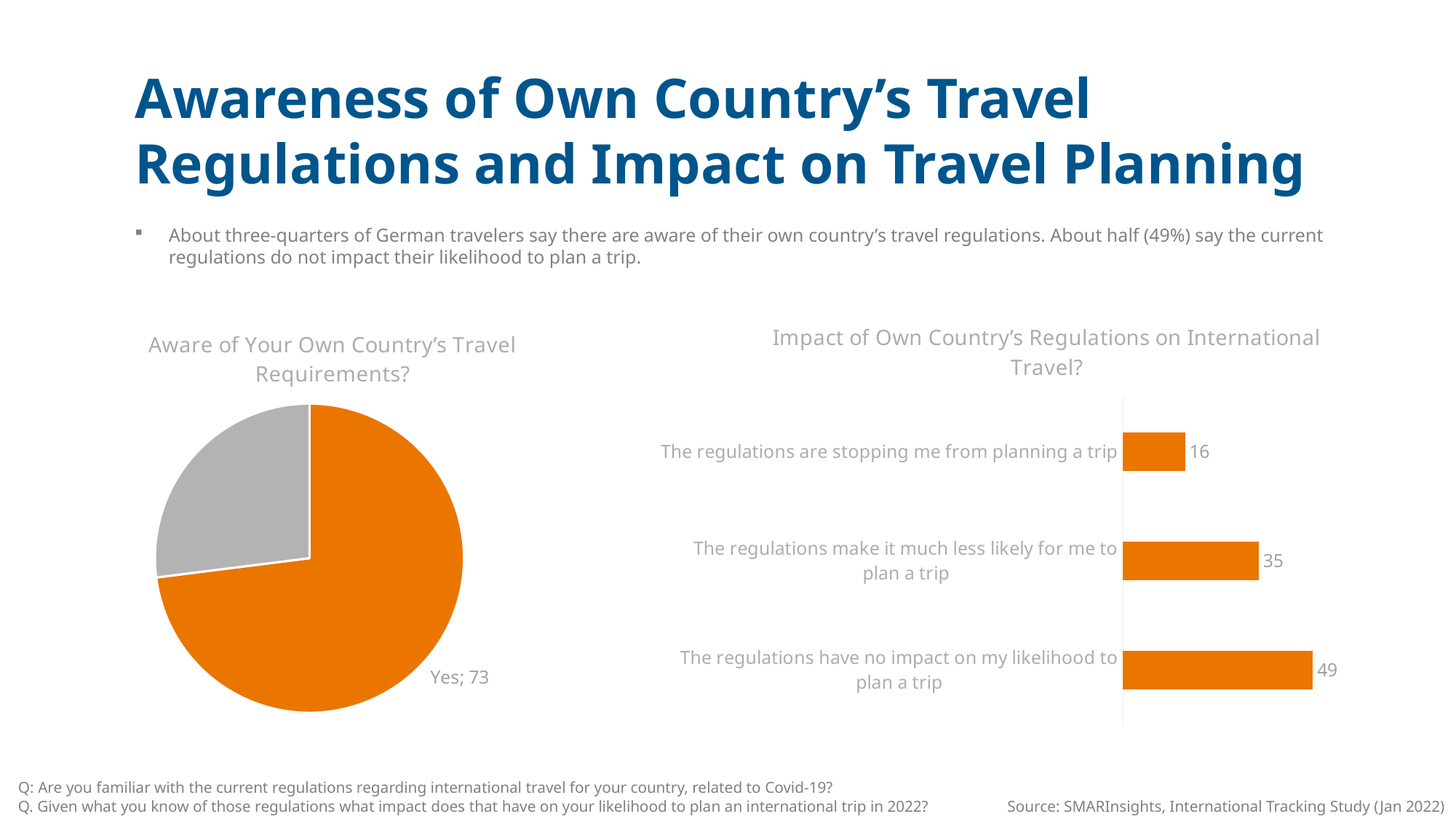
What kind of chart is the 'Impact of Own Country's Regulations on International Travel?' chart? bar chart In the 'Impact of Own Country's Regulations on International Travel?' chart, which category has the highest value? The regulations have no impact on my likelihood to plan a trip In the 'Impact of Own Country's Regulations on International Travel?' chart, what is the difference between the values for 'The regulations have no impact on my likelihood to plan a trip' and 'The regulations are stopping me from planning a trip'? 33 In the 'Aware of Your Own Country's Travel Requirements?' pie chart, what value is shown for the 'Yes' slice? 73 What kind of chart is the 'Aware of Your Own Country's Travel Requirements?' chart? pie chart In the 'Impact of Own Country's Regulations on International Travel?' chart, what is the value for 'The regulations are stopping me from planning a trip'? 16 How many categories are shown in the 'Impact of Own Country's Regulations on International Travel?' chart? 3 In the 'Impact of Own Country's Regulations on International Travel?' chart, what is the value for 'The regulations have no impact on my likelihood to plan a trip'? 49 In the 'Aware of Your Own Country's Travel Requirements?' pie chart, what colour is the 'Yes' slice? orange In the 'Impact of Own Country's Regulations on International Travel?' chart, which category has the lowest value? The regulations are stopping me from planning a trip In the 'Impact of Own Country's Regulations on International Travel?' chart, which is larger: 'The regulations make it much less likely for me to plan a trip' or 'The regulations are stopping me from planning a trip'? The regulations make it much less likely for me to plan a trip In the 'Impact of Own Country's Regulations on International Travel?' chart, what is the value for 'The regulations make it much less likely for me to plan a trip'? 35